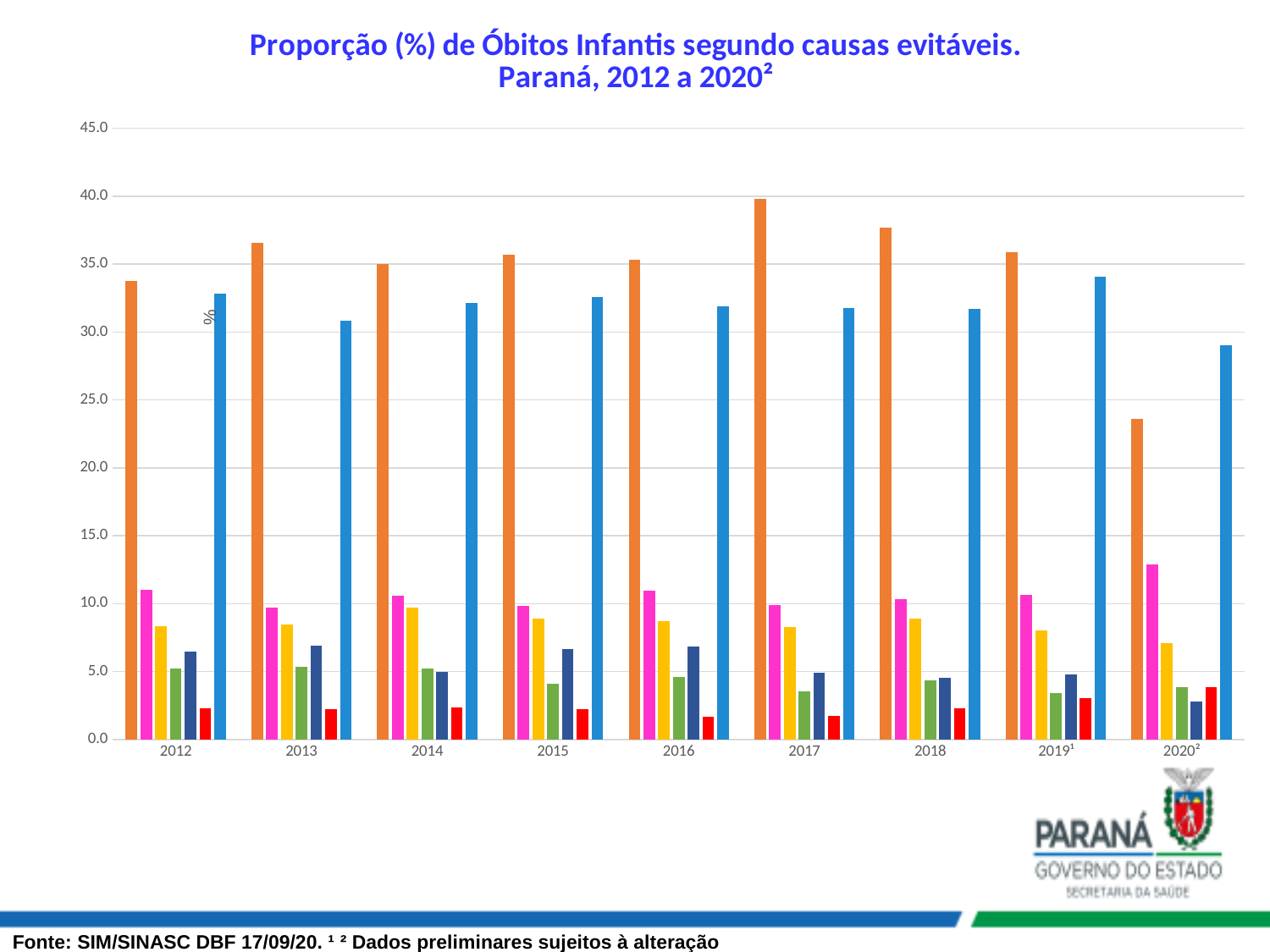
In which year is the pink bar the highest? 2020² In 2020², which is larger: the orange bar or the light blue bar? the light blue bar Is the value of the orange bar for 2017 greater or less than 35.0? greater In which year is the orange bar the lowest? 2020² How many bars are plotted for each year in the chart? 7 What kind of chart is shown on the slide? bar chart Is the value of the pink bar for 2020² greater or less than 10.0? greater How many years are shown along the x axis of the chart? 9 In which year is the orange bar the highest? 2017 In which year is the light blue bar the highest? 2019¹ Is the value of the orange bar for 2020² greater or less than 25.0? less What is the title of the chart? Proporção (%) de Óbitos Infantis segundo causas evitáveis. Paraná, 2012 a 2020²